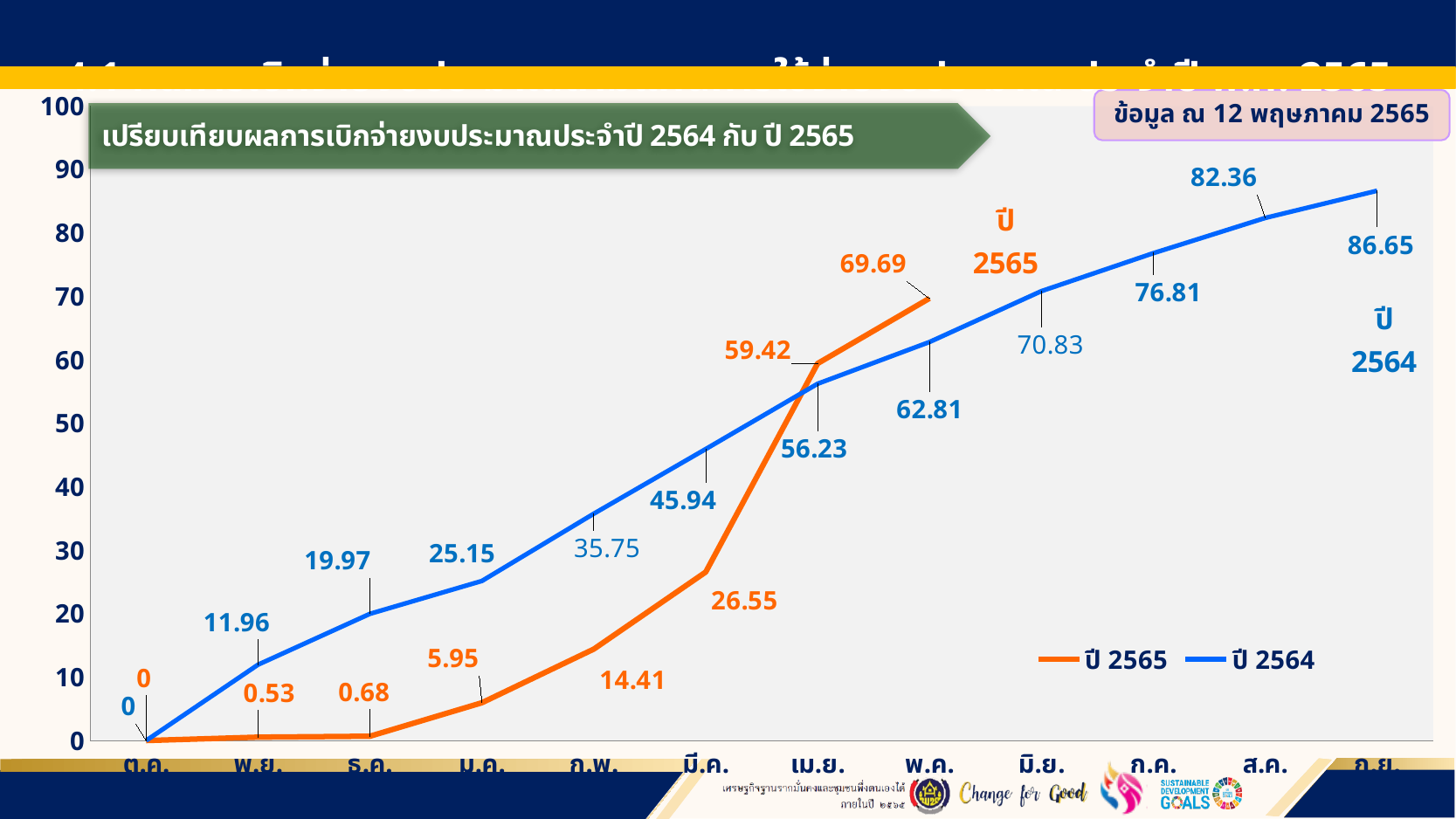
How many series does the legend list? 2 Does the ปี 2564 series rise or fall from ต.ค. to ก.ย.? rise What type of chart is shown on the slide? line chart How many months are shown on the x axis? 12 Which series has the larger value in เม.ย., ปี 2565 or ปี 2564? ปี 2565 In which month does the ปี 2564 series reach its highest value? ก.ย. What is the difference between ปี 2565 and ปี 2564 in พ.ค.? 6.88 What is the value for ปี 2565 in พ.ค.? 69.69 Which series has the larger value in ม.ค., ปี 2565 or ปี 2564? ปี 2564 What is the value for ปี 2564 in ก.ย.? 86.65 What is the value for ปี 2565 in มี.ค.? 26.55 What is the value for ปี 2564 in เม.ย.? 56.23